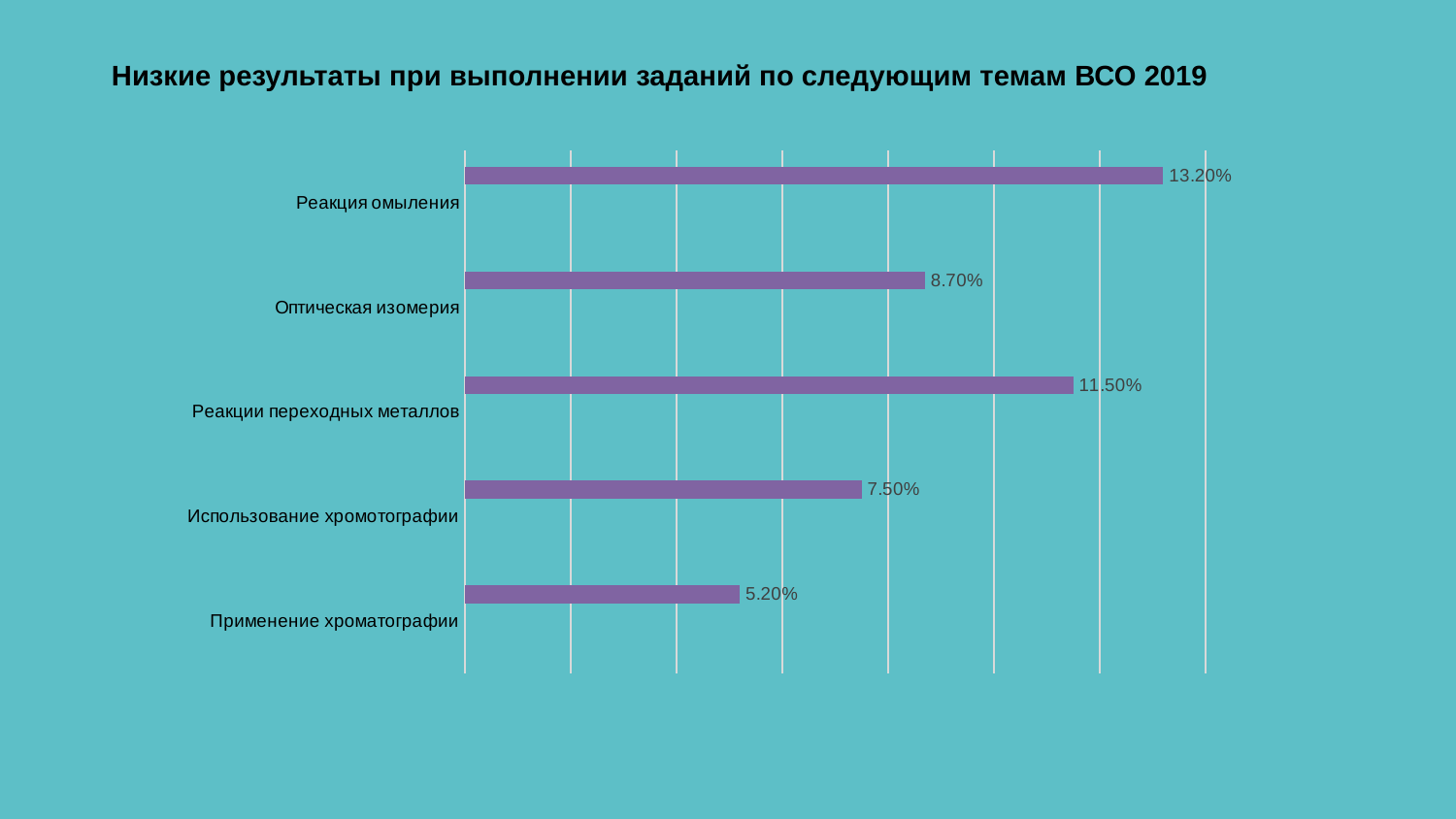
What is the value for Реакции переходных металлов? 11.50% Which category has the highest value? Реакция омыления What kind of chart is shown on the slide? Bar chart Which is larger, the value for Оптическая изомерия or the value for Реакции переходных металлов? Реакции переходных металлов What is the value for Оптическая изомерия? 8.70% Which category has the lowest value? Применение хроматографии What is the value for Использование хромотографии? 7.50% What is the difference between the values for Реакция омыления and Оптическая изомерия? 4.50% What is the value for Применение хроматографии? 5.20% What is the value for Реакция омыления? 13.20% What is the difference between the values for Реакции переходных металлов and Использование хромотографии? 4.00% How many categories are shown in the chart? 5